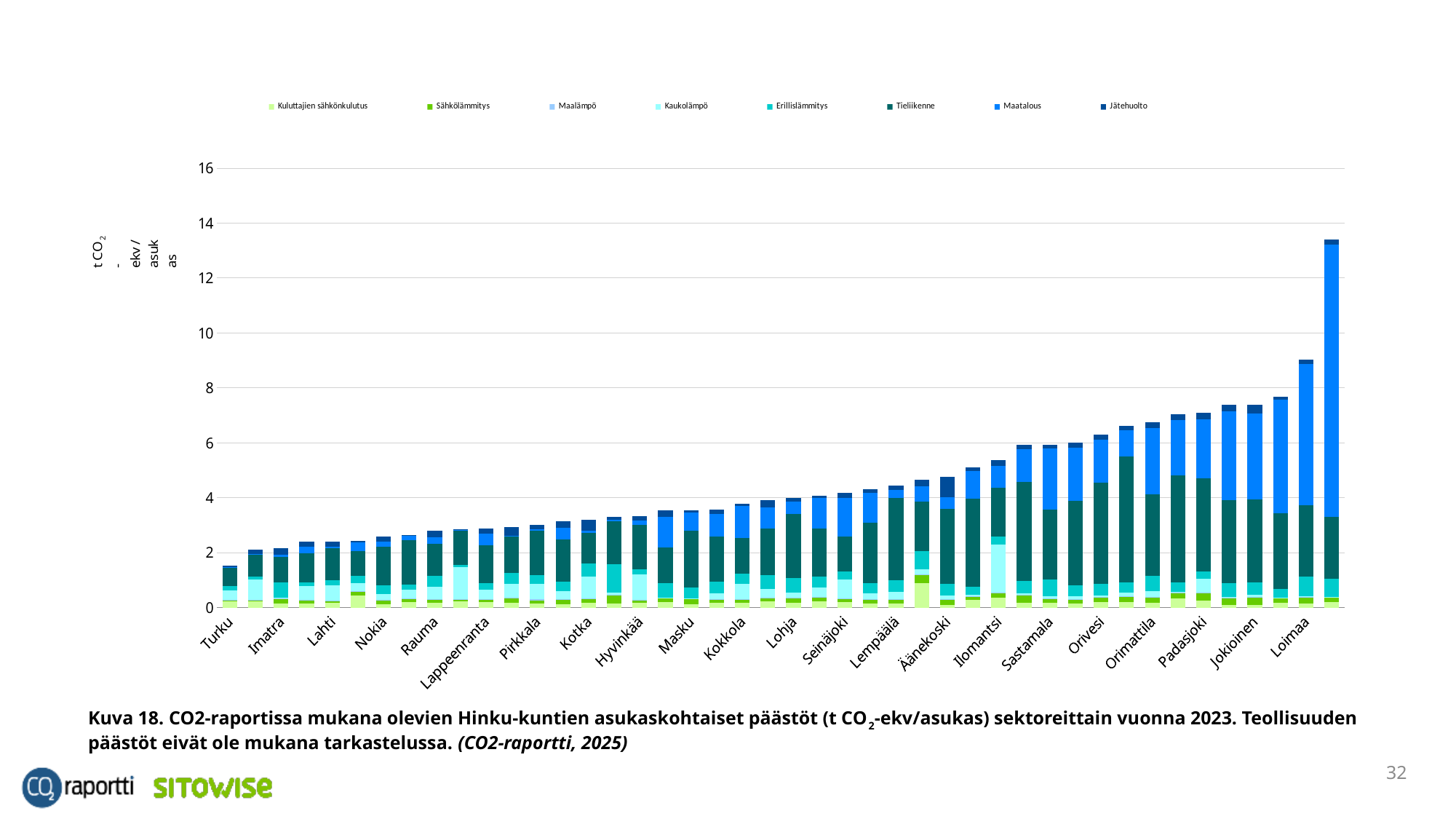
What is the first series listed in the legend? Kuluttajien sähkönkulutus Is the total value for Loimaa greater or less than 8? greater Which labelled municipality has the lowest total emissions per inhabitant? Turku What kind of chart is shown on the slide? Stacked bar chart Which has the larger total emissions per inhabitant, Turku or Loimaa? Loimaa Is the total value for Lahti greater or less than 4? less Which labelled municipality has the highest total emissions per inhabitant? Loimaa How many series does the legend list? 8 Is the total value for Orimattila greater or less than 6? greater Do the total bar heights rise or fall from left to right along the x axis? Rise What is the last series listed in the legend? Jätehuolto